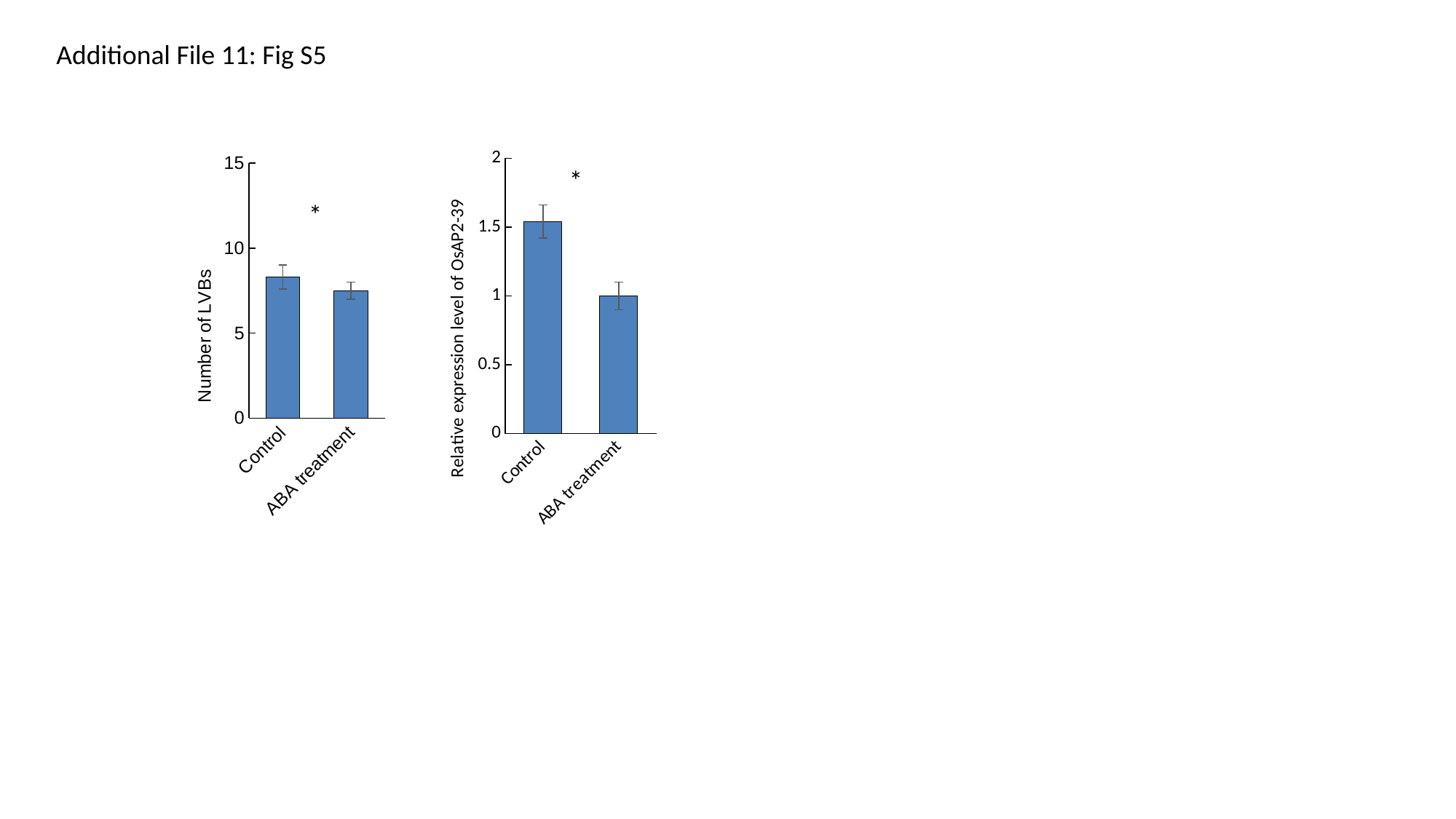
How many categories are shown on the x axis of the left chart (Number of LVBs)? 2 What kind of chart is the left chart, with y-axis 'Number of LVBs'? bar chart In the left chart (Number of LVBs), is the value for Control greater or less than 5? greater In the left chart (Number of LVBs), which category has the higher bar, Control or ABA treatment? Control In the right chart (Relative expression level of OsAP2-39), is the value for ABA treatment greater or less than 1.5? less In the left chart (Number of LVBs), is the value for Control greater or less than 10? less What is the maximum value shown on the y axis of the right chart (Relative expression level of OsAP2-39)? 2 In the right chart (Relative expression level of OsAP2-39), do the values rise or fall from Control to ABA treatment? fall In the right chart (Relative expression level of OsAP2-39), which category has the highest bar? Control What is the y-axis label of the right chart? Relative expression level of OsAP2-39